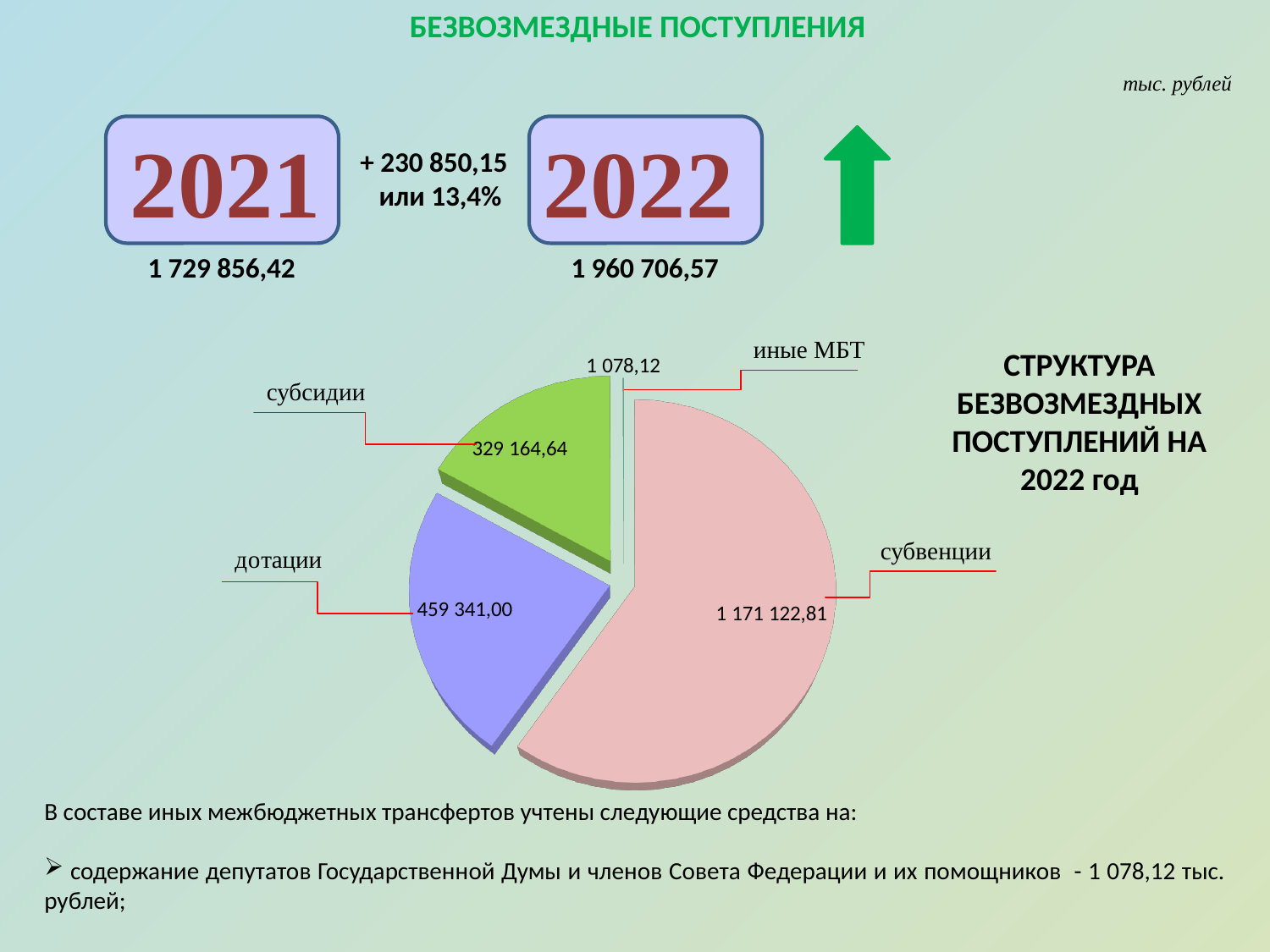
What is the value for иные МБТ in the pie chart? 1 078,12 What is the value for субсидии in the pie chart? 329 164,64 What is the title of the pie chart? СТРУКТУРА БЕЗВОЗМЕЗДНЫХ ПОСТУПЛЕНИЙ НА 2022 год What kind of chart is shown on the slide? pie chart What is the difference between the values for субвенции and дотации in the pie chart? 711 781,81 Which category has the smallest slice in the pie chart? иные МБТ What is the total of all four slices in the pie chart? 1 960 706,57 How many slices does the pie chart have? 4 Which is larger in the pie chart, дотации or субсидии? дотации Which category has the largest slice in the pie chart? субвенции What is the value for дотации in the pie chart? 459 341,00 What is the value for субвенции in the pie chart? 1 171 122,81